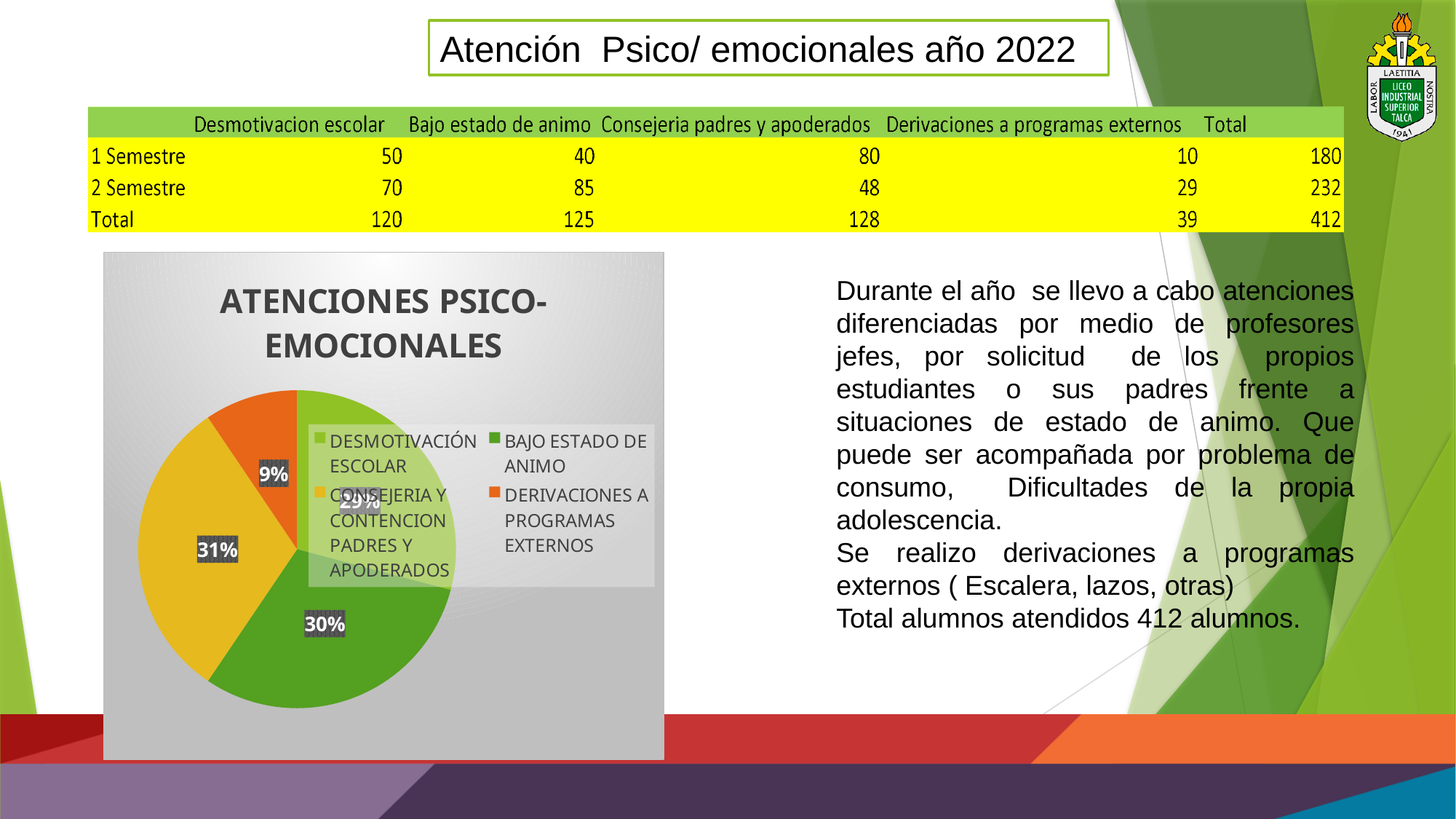
What share of the pie does BAJO ESTADO DE ANIMO represent? 30% Which is larger, the slice for BAJO ESTADO DE ANIMO or the slice for DERIVACIONES A PROGRAMAS EXTERNOS? BAJO ESTADO DE ANIMO What kind of chart is shown on the slide? pie chart What share of the pie does DERIVACIONES A PROGRAMAS EXTERNOS represent? 9% What share of the pie does DESMOTIVACIÓN ESCOLAR represent? 29% What is the chart's title? ATENCIONES PSICO-EMOCIONALES How many slices does the pie chart have? 4 Which category has the smallest slice of the pie? DERIVACIONES A PROGRAMAS EXTERNOS What is the difference in percentage points between CONSEJERIA Y CONTENCION PADRES Y APODERADOS and DERIVACIONES A PROGRAMAS EXTERNOS? 22% Which category has the largest slice of the pie? CONSEJERIA Y CONTENCION PADRES Y APODERADOS How many entries does the legend list? 4 What share of the pie does CONSEJERIA Y CONTENCION PADRES Y APODERADOS represent? 31%